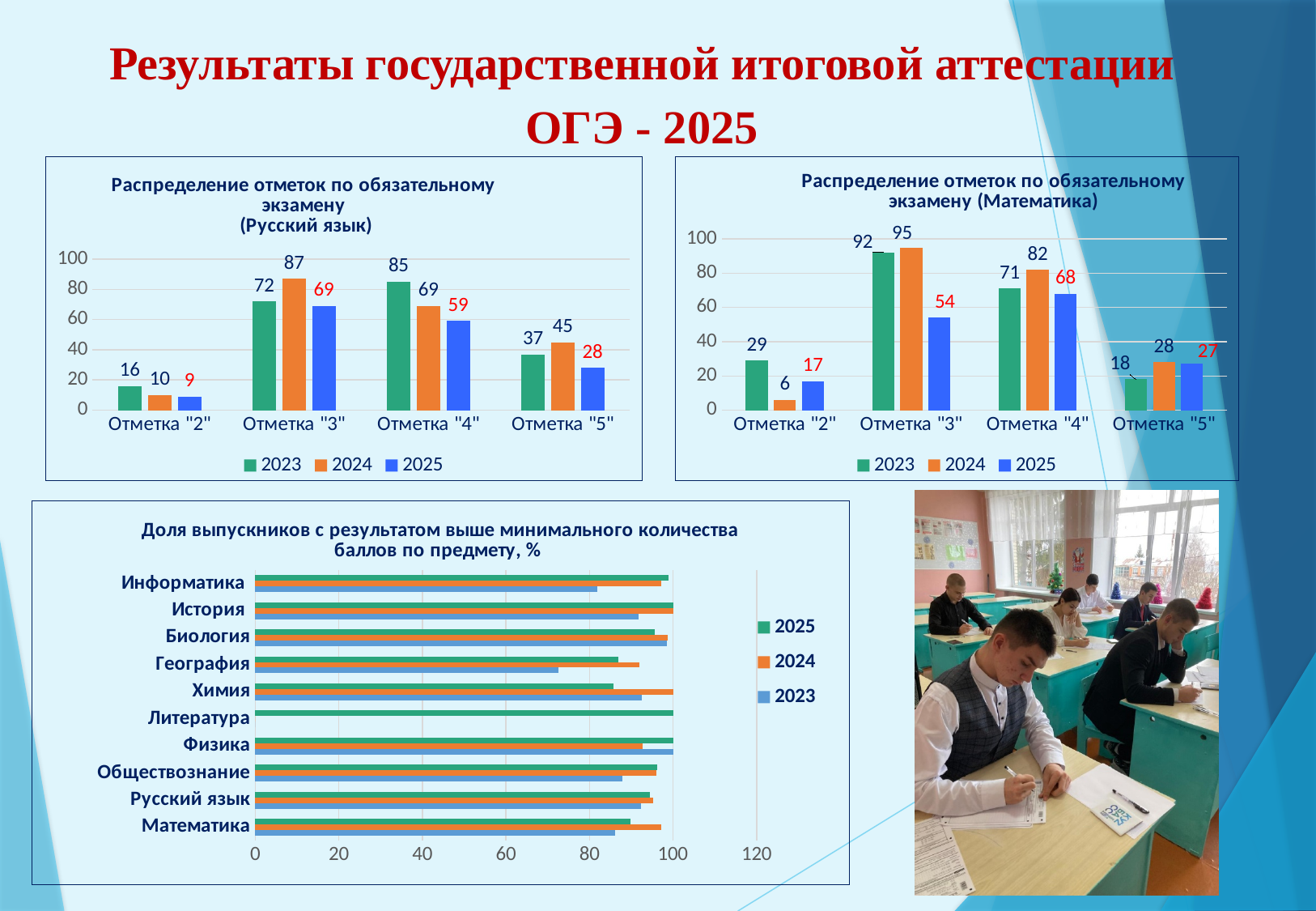
In the Mathematics chart (Математика), which year has the lowest value at Отметка "2"? 2024 In the Russian language chart (Русский язык), which year has the highest value at Отметка "4"? 2023 In the Mathematics chart (Математика), what is the value for 2025 at Отметка "3"? 54 How many subjects are shown in the bottom-left chart (Доля выпускников с результатом выше минимального количества баллов по предмету, %)? 10 In the bottom-left chart (Доля выпускников...), is the 2023 value for География greater or less than 80? less What kind of chart is the bottom-left chart (Доля выпускников с результатом выше минимального количества баллов по предмету, %)? bar chart In the Russian language chart (Русский язык), what is the value for 2025 at Отметка "2"? 9 In the Mathematics chart (Математика), what is the difference between the 2024 and 2023 values at Отметка "3"? 3 In the Russian language chart (Русский язык), what is the value for 2024 at Отметка "3"? 87 How many series does the legend of the Mathematics chart (Математика) list? 3 In the Mathematics chart (Математика), is the 2024 value at Отметка "4" larger or smaller than the 2023 value at Отметка "4"? larger In the Russian language chart (Русский язык), what is the difference between the 2024 and 2025 values at Отметка "5"? 17